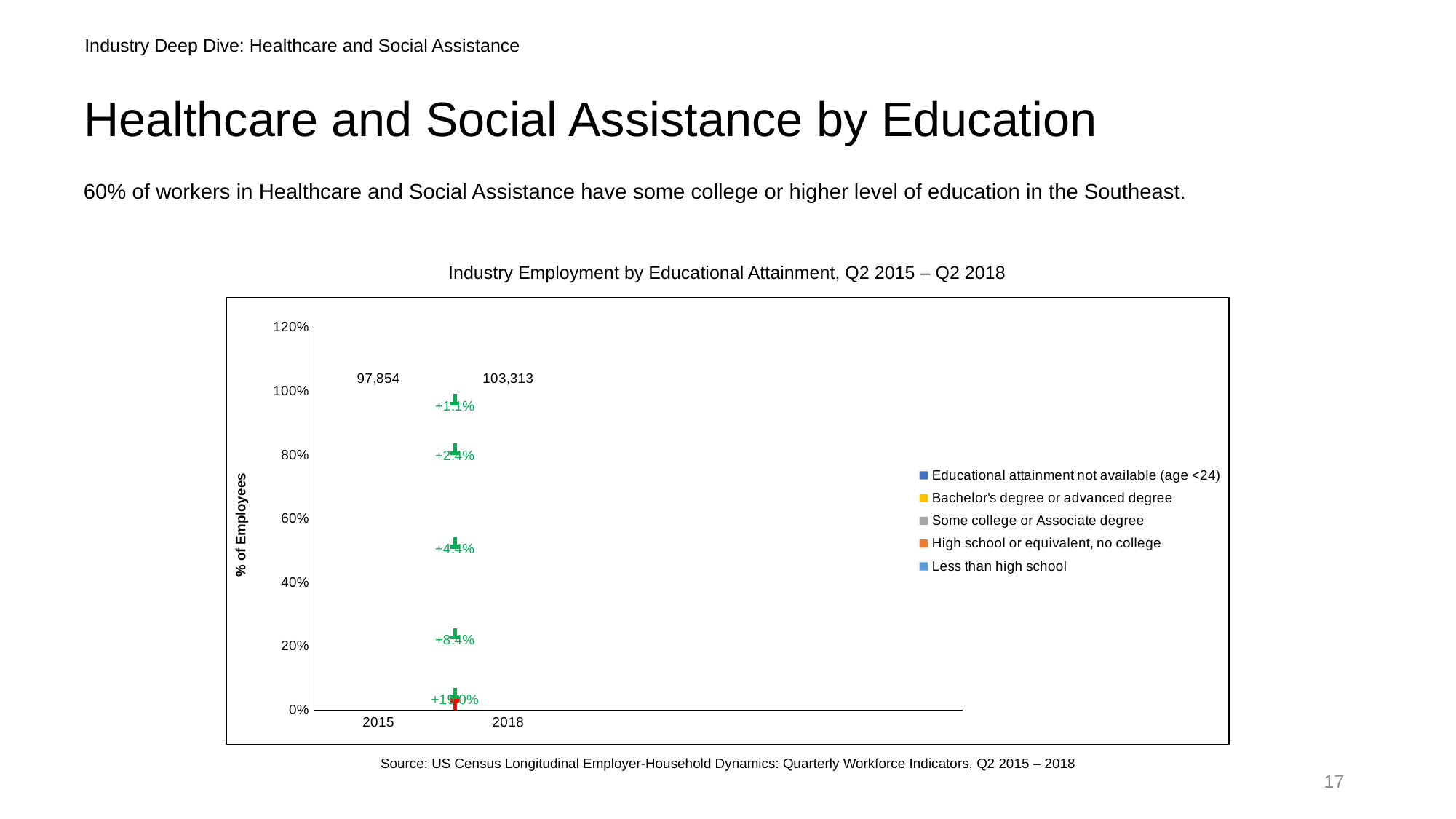
What is the label on the y axis of the chart? % of Employees What total employment figure is printed above the 2018 bar? 103,313 How many years are shown on the x axis of the chart? 2 What is the difference between the total employment figures printed for 2018 and 2015? 5,459 Is the total employment figure printed for 2018 greater or less than 100,000? greater What total employment figure is printed above the 2015 bar? 97,854 Is the total employment figure printed for 2015 greater or less than 100,000? less Does the total employment figure rise or fall from 2015 to 2018? rise How many series does the chart's legend list? 5 Which year has the larger total employment figure printed above its bar, 2015 or 2018? 2018 What is the smallest percentage change label printed between the 2015 and 2018 bars? +1.1% What is the title of the chart? Industry Employment by Educational Attainment, Q2 2015 – Q2 2018